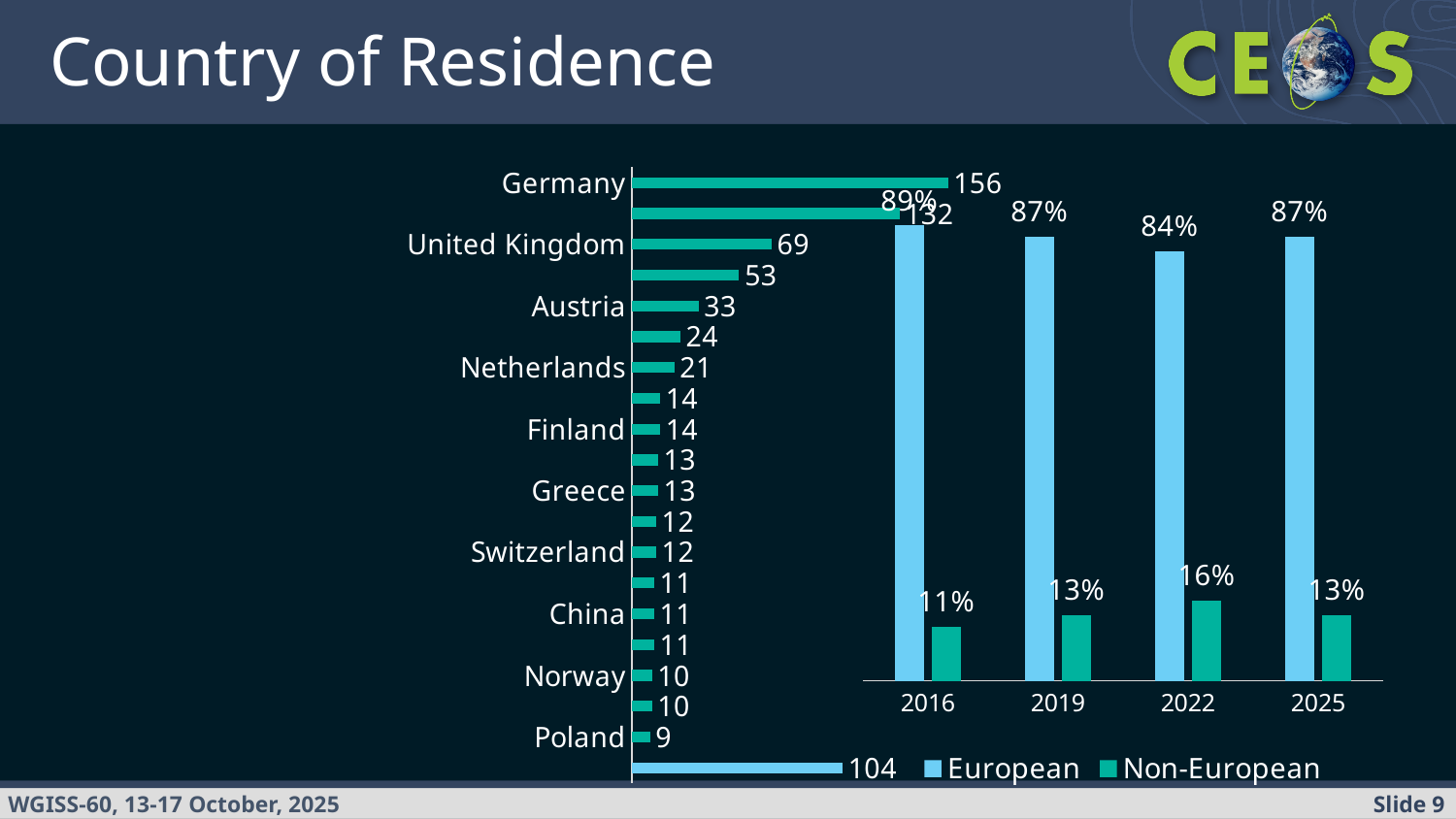
On the left bar chart, what is the value for United Kingdom? 69 How many series does the legend of the right chart list? 2 On the left bar chart, what is the value for Netherlands? 21 On the left bar chart, what is the difference between the values for Germany and United Kingdom? 87 On the left bar chart, what is the value for Germany? 156 On the right chart, in which year is the Non-European value highest? 2022 On the right chart, what is the Non-European value for 2016? 11% How many years are shown on the x axis of the right chart? 4 On the left bar chart, which has the larger value, Finland or Greece? Finland On the right chart, what is the European value for 2022? 84% What kind of chart is the chart on the left of the slide? bar chart On the left bar chart, what is the value for Austria? 33